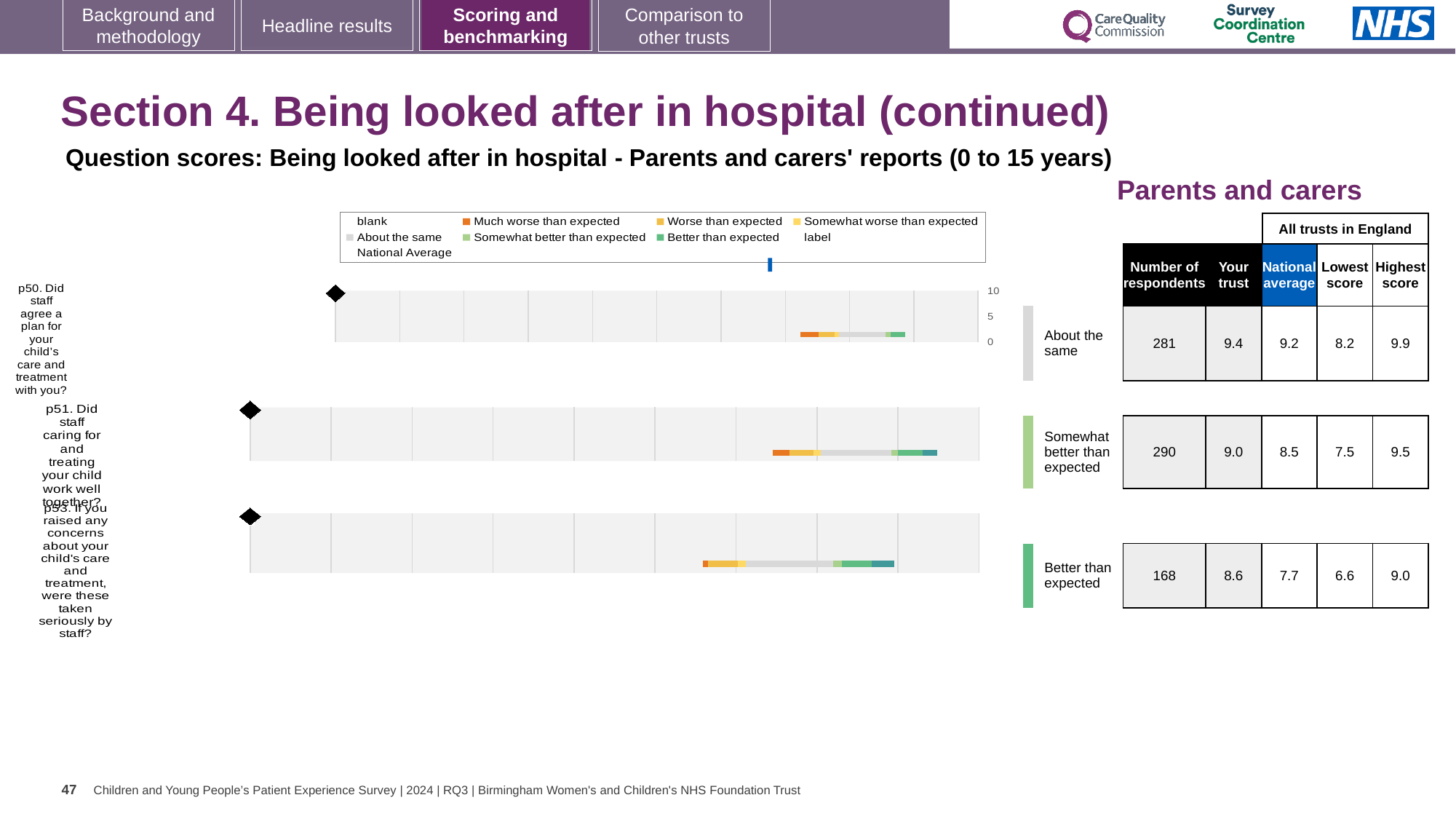
In the chart legend, which colour represents 'Much worse than expected'? orange For the p50 chart, which is larger: the 'Your trust' score or the national average? Your trust For the p51 chart (Did staff caring for and treating your child work well together?), what is the national average score? 8.5 For the p53 chart, what is the lowest score among all trusts in England? 6.6 For the p53 chart, what is the difference between the 'Your trust' score and the national average? 0.9 For the p53 chart (If you raised any concerns about your child's care and treatment, were these taken seriously by staff?), what is the number of respondents? 168 How many question rows (charts) are shown on the slide? 3 What is the highest tick value shown on the axis of the p50 chart? 10 For the p50 chart (Did staff agree a plan for your child's care and treatment with you?), what is the 'Your trust' score? 9.4 Which of the three question charts has the lowest 'Your trust' score? p53 What kind of chart is used for the p50 question row? bar chart Which of the three question charts has the highest number of respondents? p51